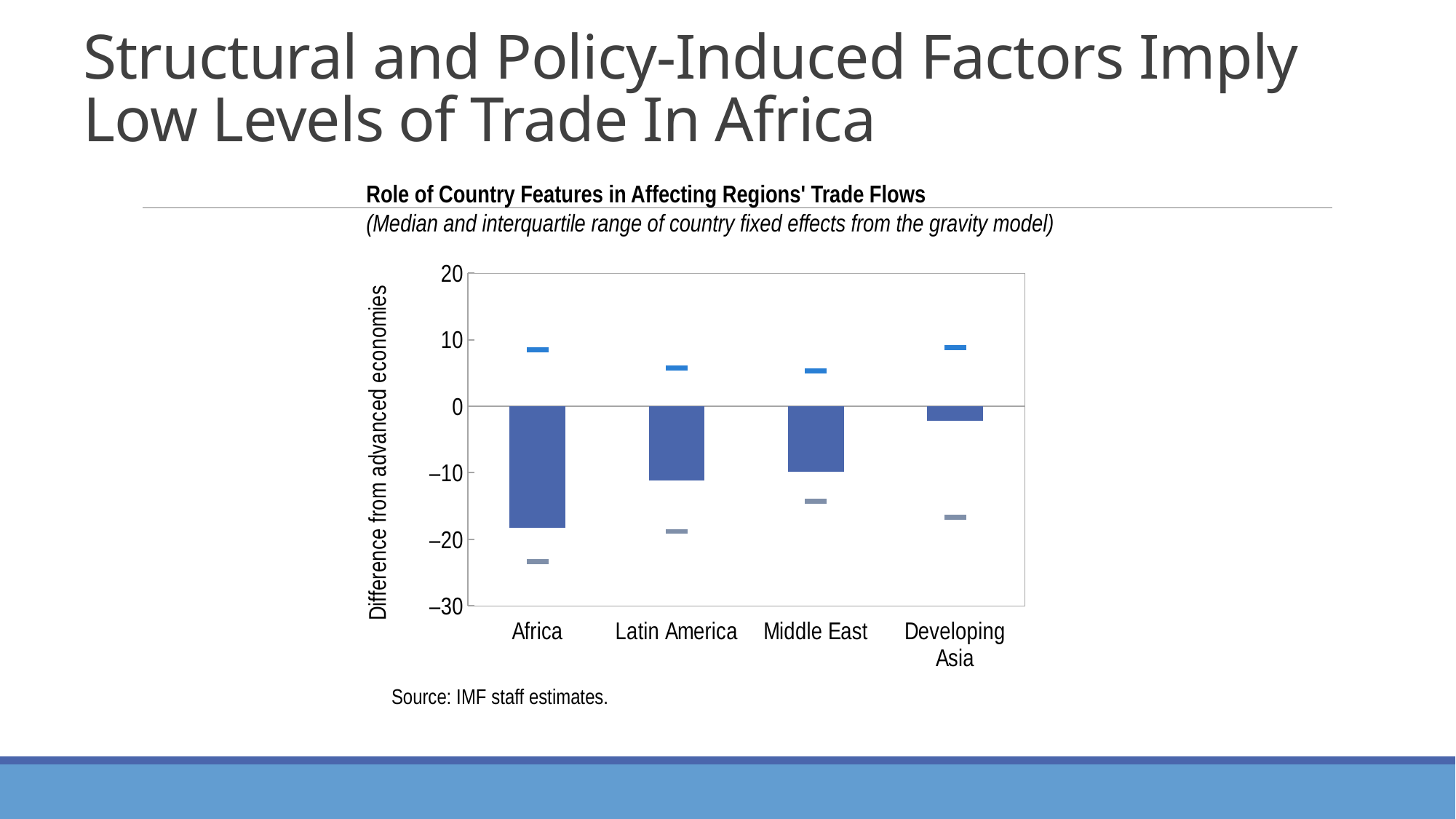
Which bar is larger (less negative), Africa or Latin America? Latin America Is the bar value for Africa greater or less than –10? less What is the label on the vertical axis of the chart? Difference from advanced economies Is the bar value for Africa greater or less than –15? less Is the bar value for Developing Asia greater or less than –10? greater What is the title of the chart? Role of Country Features in Affecting Regions' Trade Flows How many regions are shown on the x axis of the chart? 4 Which region has the highest (least negative) bar in the chart? Developing Asia What kind of chart is shown on the slide? bar chart Which bar is larger (less negative), Middle East or Developing Asia? Developing Asia Which region has the lowest (most negative) bar in the chart? Africa